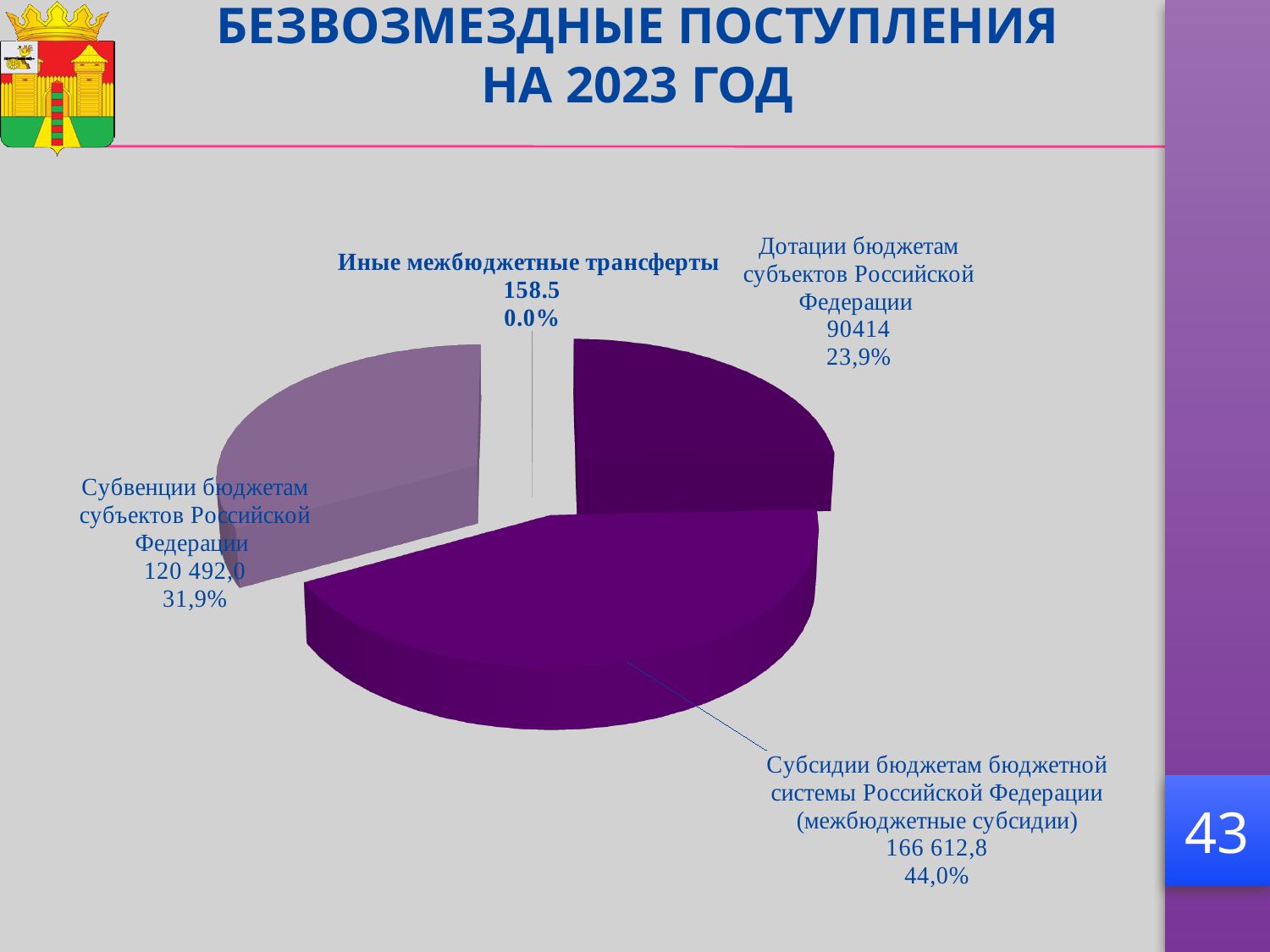
What is the value for Иные межбюджетные трансферты? 158.5 What is the value for Субвенции бюджетам субъектов Российской Федерации? 120 492,0 What is the value for Субсидии бюджетам бюджетной системы Российской Федерации (межбюджетные субсидии)? 166 612,8 What is the value for Дотации бюджетам субъектов Российской Федерации? 90414 What share of the pie does Дотации бюджетам субъектов Российской Федерации represent? 23,9% What share of the pie does Субвенции бюджетам субъектов Российской Федерации represent? 31,9% Which is larger: Субвенции бюджетам субъектов Российской Федерации or Дотации бюджетам субъектов Российской Федерации? Субвенции бюджетам субъектов Российской Федерации Which category has the largest slice of the pie? Субсидии бюджетам бюджетной системы Российской Федерации (межбюджетные субсидии) What type of chart is shown on the slide? Pie chart How many slices does the pie chart have? 4 What is the difference in percentage share between Субсидии бюджетам бюджетной системы Российской Федерации (межбюджетные субсидии) and Субвенции бюджетам субъектов Российской Федерации? 12,1% Which category has the smallest slice of the pie? Иные межбюджетные трансферты